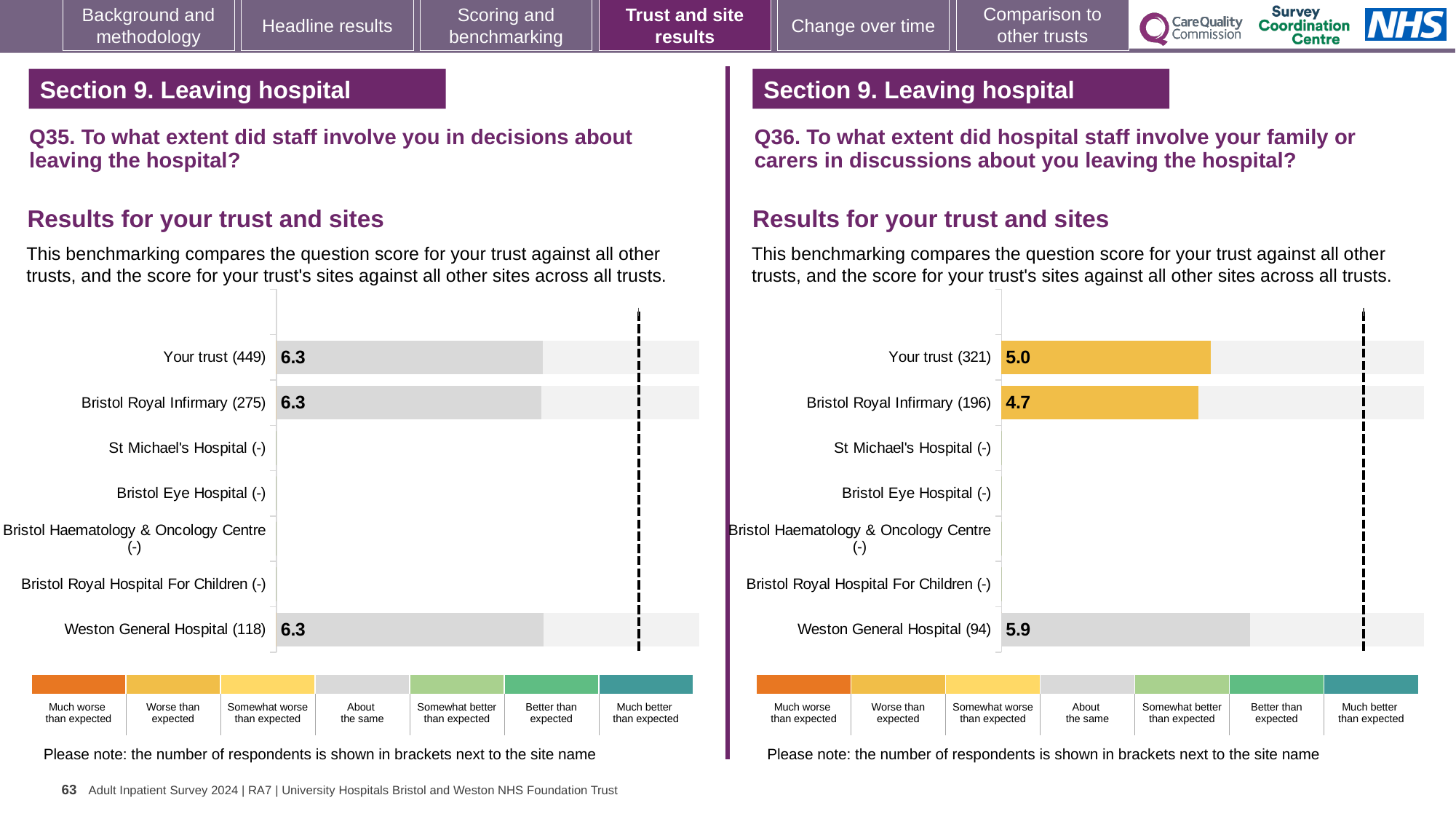
On the Q36 chart (right), how many respondents are shown in brackets for Your trust? 321 On the Q36 chart (right), which has the larger score: Your trust or Bristol Royal Infirmary? Your trust On the Q36 chart (right), what is the difference between the Weston General Hospital score and the Bristol Royal Infirmary score? 1.2 On the Q36 chart (right), what is the score for Your trust? 5.0 On the Q35 chart (left), what is the score for Your trust? 6.3 How many site or trust rows are listed on the Q35 chart (left)? 7 On the Q36 chart (right), which site or trust row has the lowest score? Bristol Royal Infirmary On the Q35 chart (left), what is the score for Weston General Hospital? 6.3 On the Q36 chart (right), which site or trust row has the highest score? Weston General Hospital On the Q36 chart (right), what is the score for Bristol Royal Infirmary? 4.7 What kind of chart is the Q35 chart (left)? Bar chart On the Q36 chart (right), what is the score for Weston General Hospital? 5.9